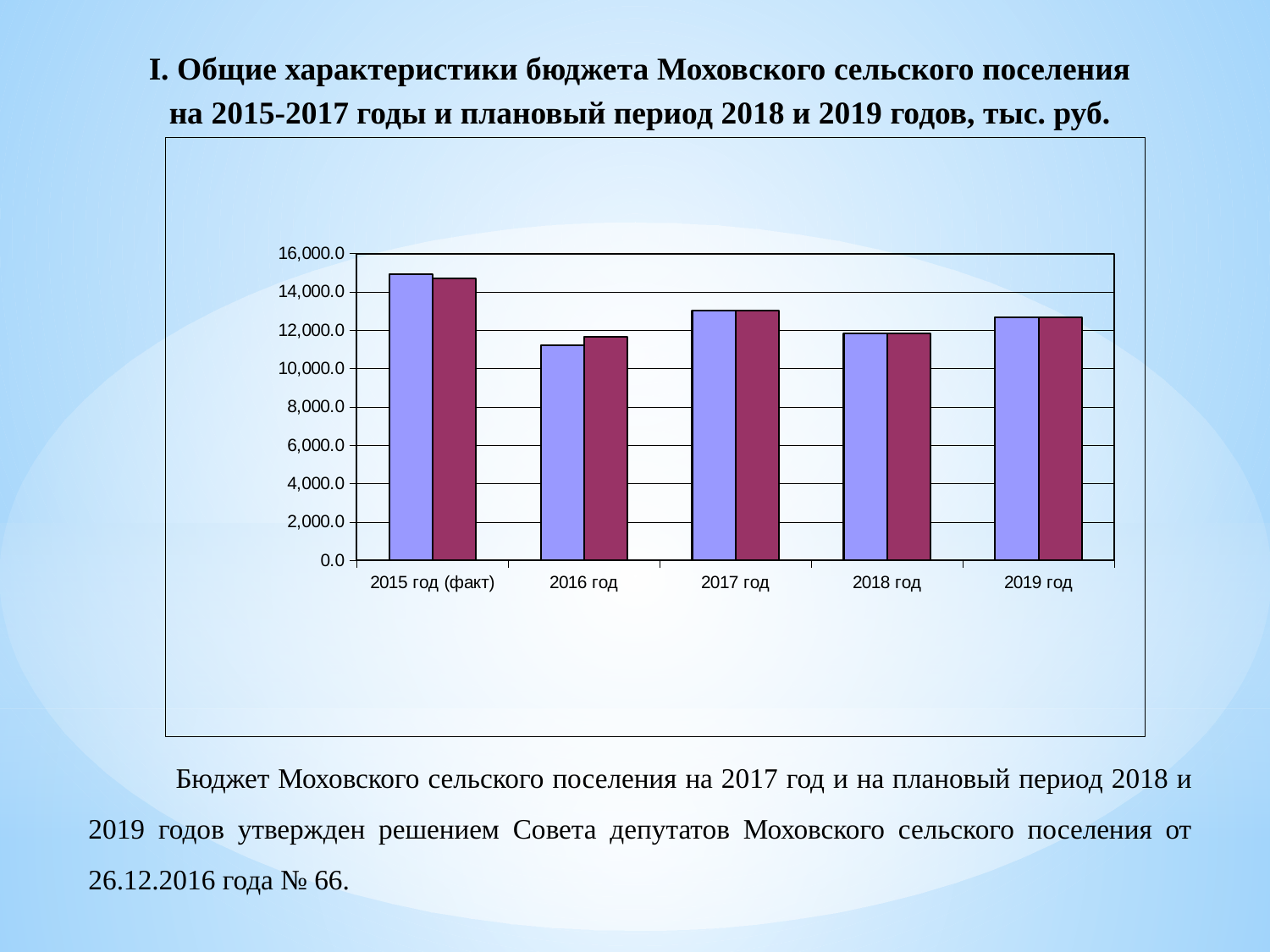
Which year has the highest bars in the chart? 2015 год (факт) How many year categories are shown on the x axis of the chart? 5 How many bars are plotted for each year category in the chart? 2 Is the value of the left (blue) bar for 2016 год greater or less than 12,000.0? less Is the value of the right (purple) bar for 2017 год greater or less than 12,000.0? greater Do the bar values rise or fall from 2015 год (факт) to 2016 год? fall Is the value of the right (purple) bar for 2019 год greater or less than 14,000.0? less What is the highest tick value shown on the vertical axis of the chart? 16,000.0 Which is larger in the chart: the left (blue) bar for 2017 год or the left (blue) bar for 2018 год? 2017 год What kind of chart is shown on the slide? bar chart Which year has the lowest left (blue) bar in the chart? 2016 год